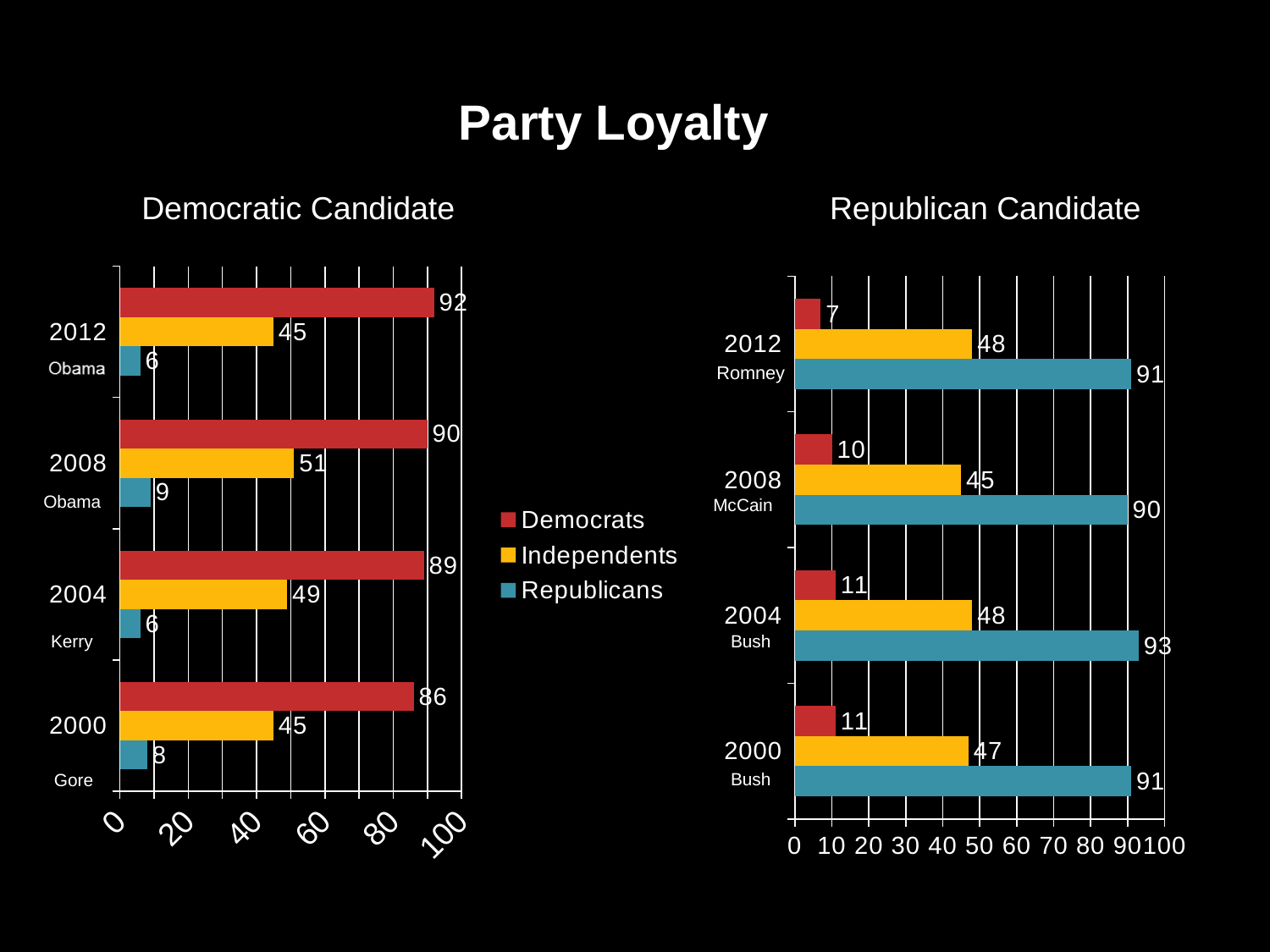
In the Democratic Candidate chart, what is the value for Independents in 2008? 51 How many years are shown in the Democratic Candidate chart? 4 In the Republican Candidate chart, which year has the lowest value for Democrats? 2012 Which colour represents Independents in the legend? Yellow In the Republican Candidate chart, what is the value for Republicans in 2004? 93 What kind of chart is the Republican Candidate chart? Bar chart In the Democratic Candidate chart, which year has the highest value for Democrats? 2012 In the Republican Candidate chart, what is the value for Democrats in 2012? 7 In the Democratic Candidate chart, what is the difference between the Democrats value and the Republicans value in 2000? 78 How many series does the legend list? 3 In the Democratic Candidate chart, what is the value for Democrats in 2012? 92 In the Republican Candidate chart, which is larger: the Independents value in 2012 or the Independents value in 2008? 2012